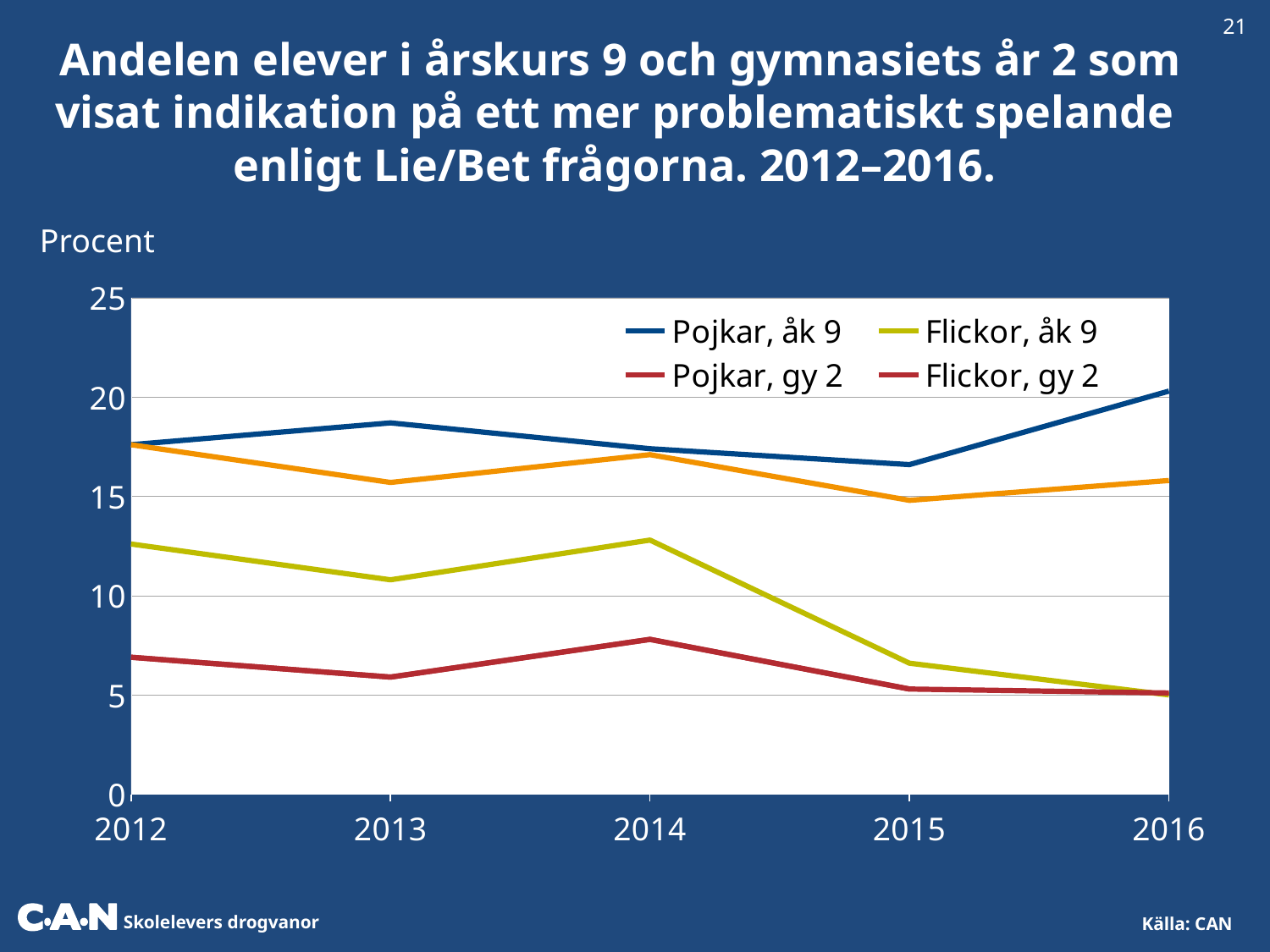
What unit label is shown above the y axis? Procent Is the value for Pojkar, åk 9 in 2016 greater or less than 15? greater Is the value for Flickor, åk 9 in 2016 greater or less than 10? less Does the value for Flickor, åk 9 rise or fall from 2014 to 2016? fall In which year is the value for Pojkar, åk 9 highest? 2016 How many series does the legend list? 4 Is the value for Pojkar, åk 9 in 2015 greater or less than 15? greater What kind of chart is shown on the slide? line chart In which year is the value for Flickor, åk 9 lowest? 2016 In 2013, which series has the higher value: Pojkar, åk 9 or Flickor, åk 9? Pojkar, åk 9 How many years are plotted along the x axis? 5